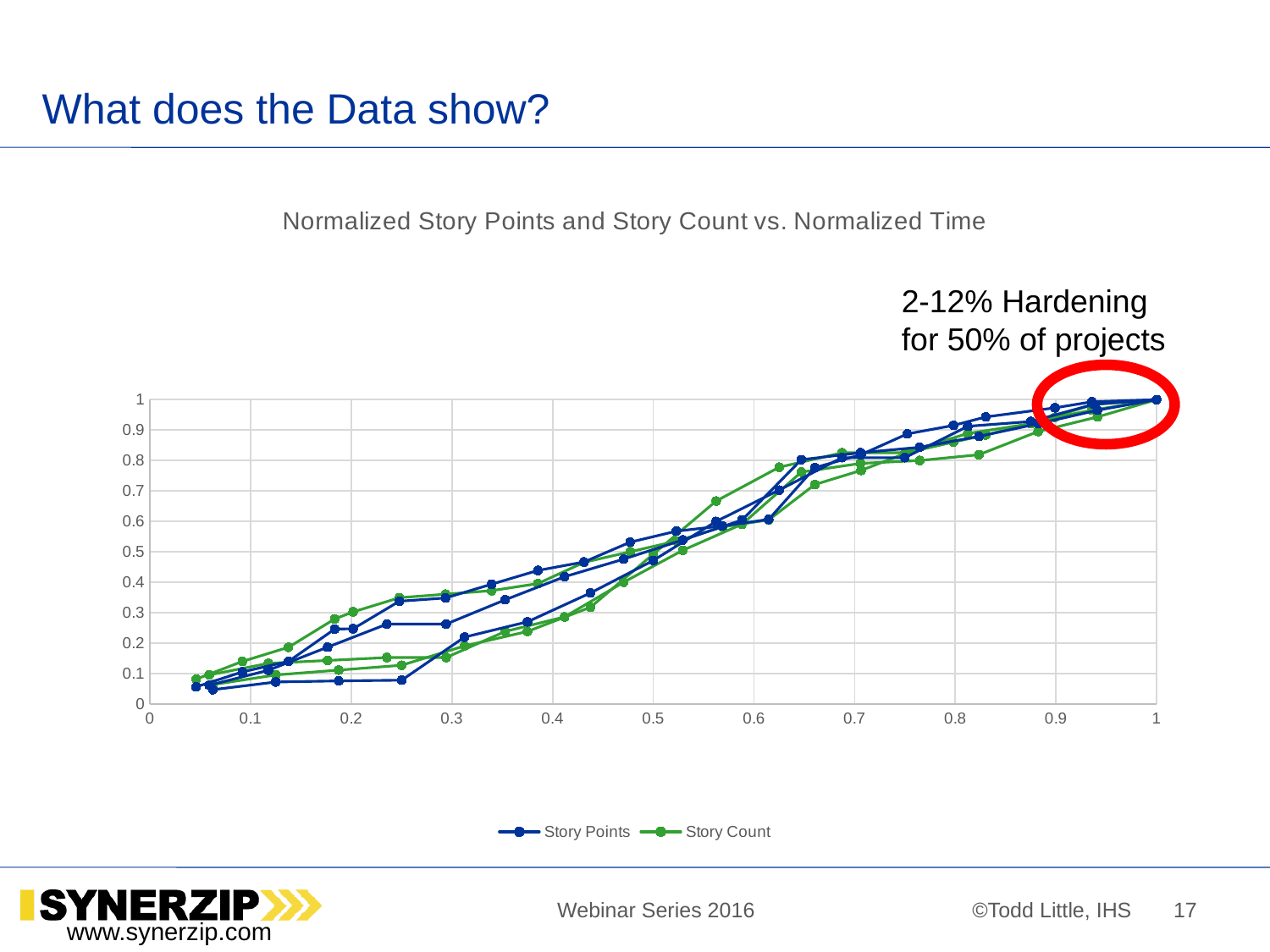
At a normalized time of 0.8, are the plotted values greater or less than 0.7? greater At a normalized time of 0.1, are the plotted values greater or less than 0.3? less Which colour represents the Story Count series in the chart? green What is the highest value labelled on the y axis of the chart? 1 What is the lowest value labelled on the x axis of the chart? 0 What type of chart is shown on the slide? line chart Do the plotted values rise or fall as normalized time increases along the x axis? rise What value do all the lines reach at a normalized time of 1? 1 At a normalized time of 0.3, are the plotted values greater or less than 0.5? less What is the title of the chart? Normalized Story Points and Story Count vs. Normalized Time How many series does the chart legend list? 2